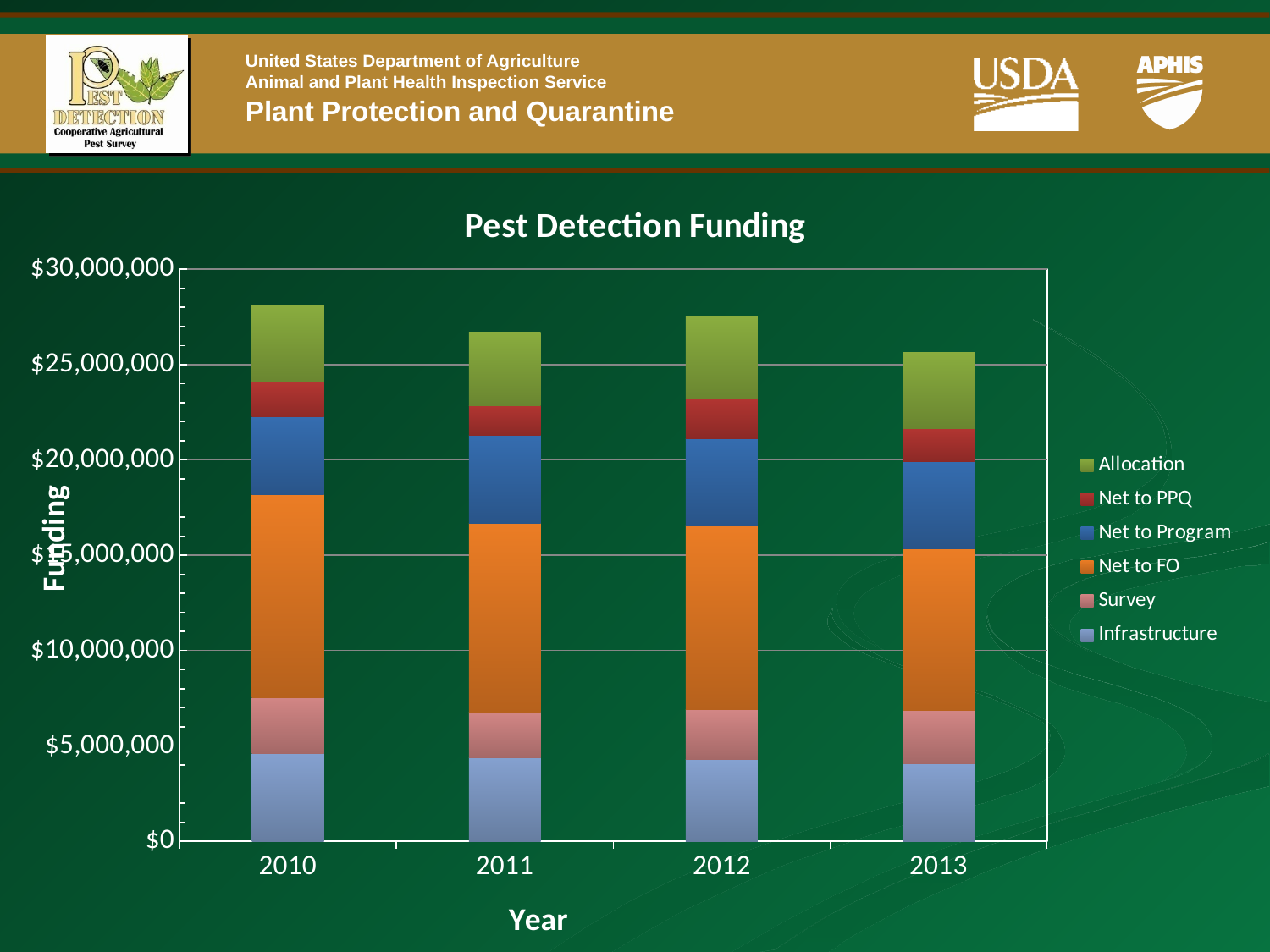
Which year has the larger total funding, 2010 or 2013? 2010 What kind of chart is shown on the slide? Stacked bar chart Which year has the lowest total funding? 2013 Which year has the highest total funding? 2010 Is the total funding for 2011 greater or less than $30,000,000? less How many series does the legend list? 6 What is the label on the vertical axis of the chart? Funding Is the Infrastructure value for 2010 greater or less than $5,000,000? less What is the title of the chart? Pest Detection Funding Is the total funding for 2010 greater or less than $25,000,000? greater Which series makes up the largest segment of each bar? Net to FO How many years are shown on the x axis of the chart? 4